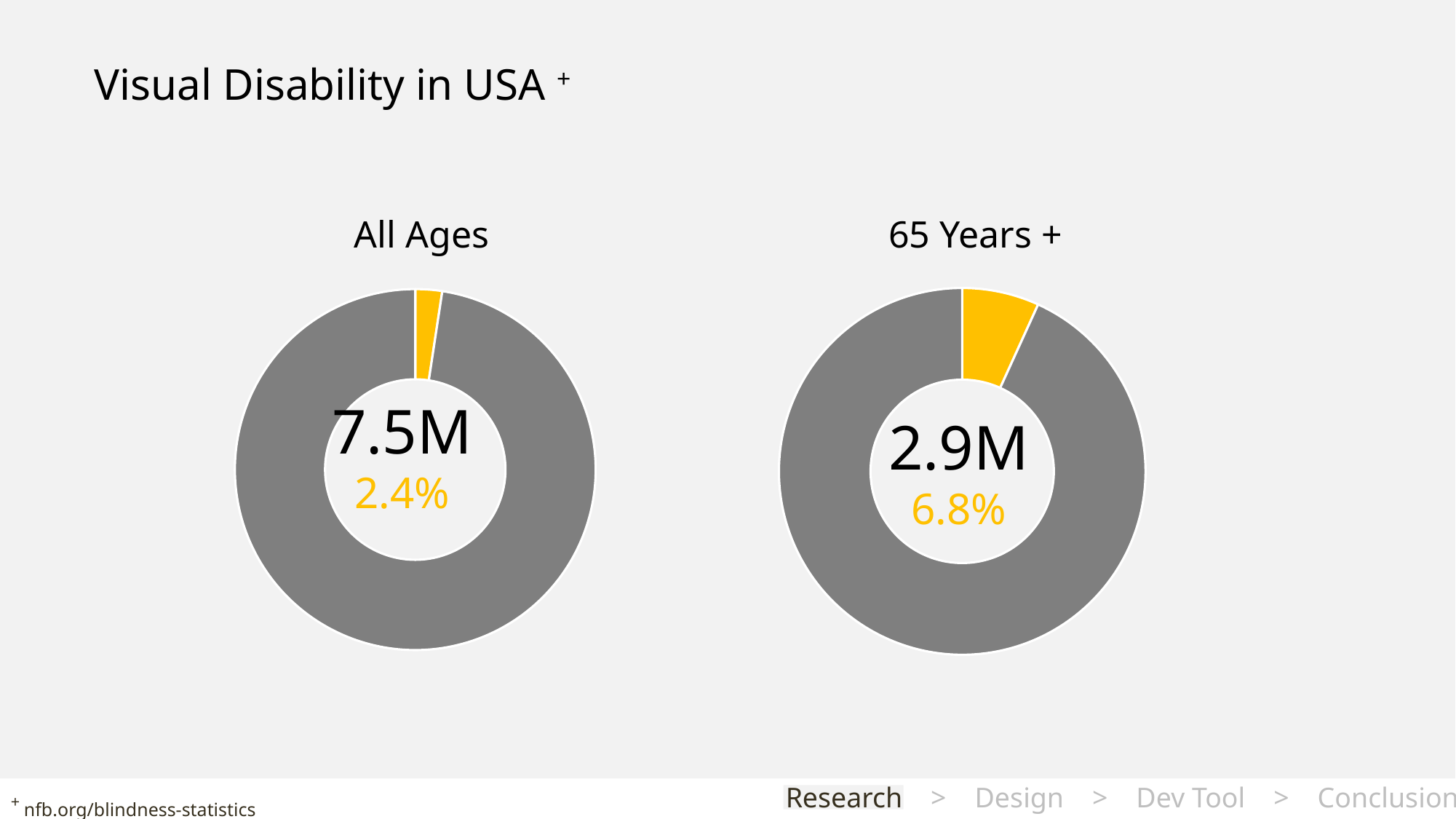
What kind of chart is used for 'All Ages' and '65 Years +'? Donut (pie) chart In the '65 Years +' chart, what number is printed in the centre of the donut? 2.9M Which chart shows the larger yellow share, 'All Ages' or '65 Years +'? 65 Years + What is the difference between the percentage shown in the '65 Years +' chart and the percentage shown in the 'All Ages' chart? 4.4% What colour is the slice representing the visually disabled share in both charts? Yellow How many slices does each donut chart have? 2 What is the title of the slide containing the two donut charts? Visual Disability in USA In the 'All Ages' chart, what percentage does the yellow slice represent? 2.4% In the '65 Years +' chart, what percentage does the yellow slice represent? 6.8% How many donut charts are shown on the slide? 2 Is the yellow share in the '65 Years +' chart greater or less than 5%? greater In the 'All Ages' chart, what number is printed in the centre of the donut? 7.5M